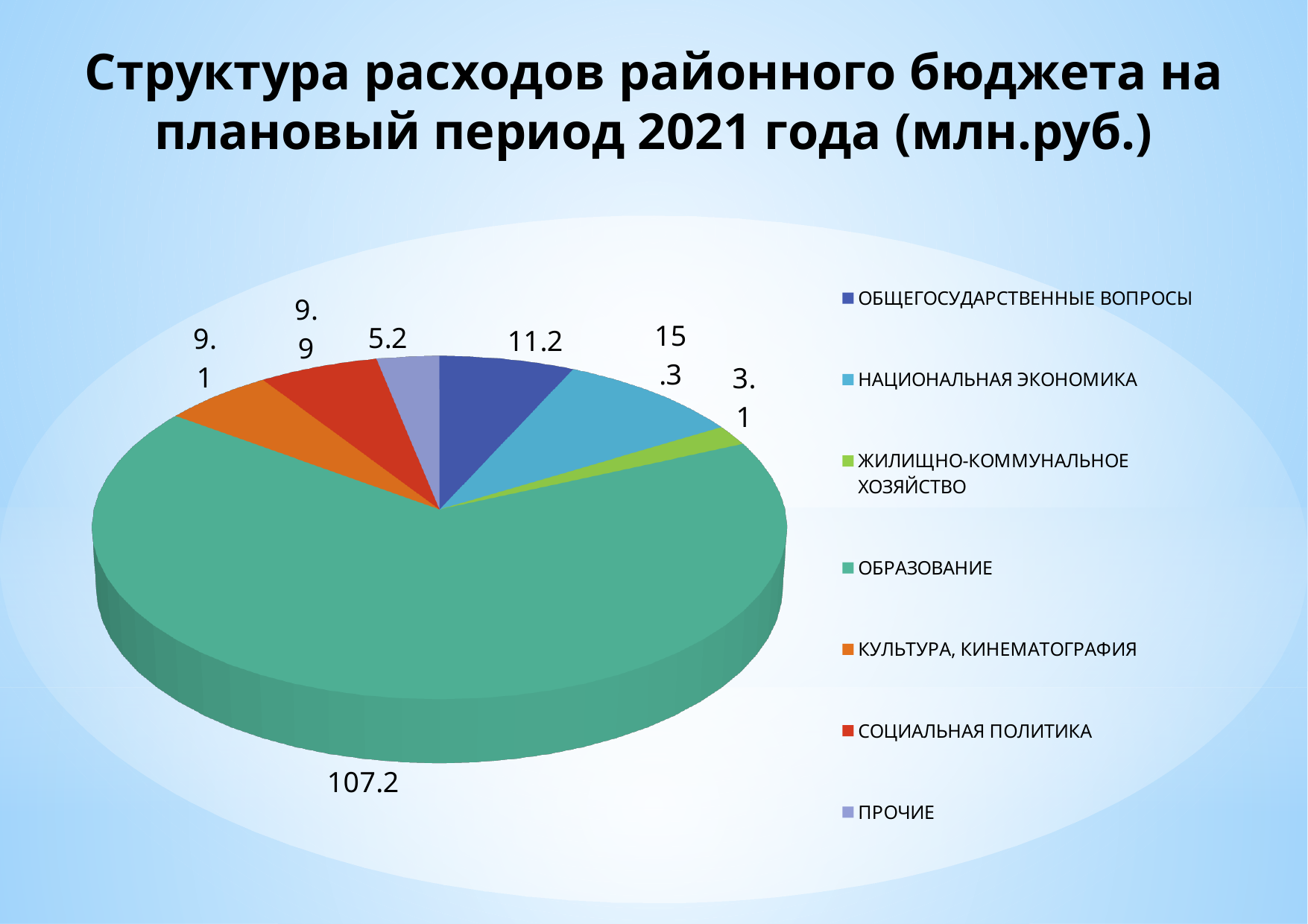
What is the difference between the values for НАЦИОНАЛЬНАЯ ЭКОНОМИКА and ОБЩЕГОСУДАРСТВЕННЫЕ ВОПРОСЫ? 4.1 What is the value for ОБЩЕГОСУДАРСТВЕННЫЕ ВОПРОСЫ? 11.2 Which is larger, the value for СОЦИАЛЬНАЯ ПОЛИТИКА or the value for КУЛЬТУРА, КИНЕМАТОГРАФИЯ? СОЦИАЛЬНАЯ ПОЛИТИКА What type of chart is shown on the slide? Pie chart How many categories does the legend list? 7 What is the value for НАЦИОНАЛЬНАЯ ЭКОНОМИКА? 15.3 Which category has the smallest slice of the pie? ЖИЛИЩНО-КОММУНАЛЬНОЕ ХОЗЯЙСТВО What is the value for ПРОЧИЕ? 5.2 What is the value for ЖИЛИЩНО-КОММУНАЛЬНОЕ ХОЗЯЙСТВО? 3.1 What is the value for ОБРАЗОВАНИЕ? 107.2 Which category has the largest slice of the pie? ОБРАЗОВАНИЕ What colour is the slice for ОБРАЗОВАНИЕ? Green